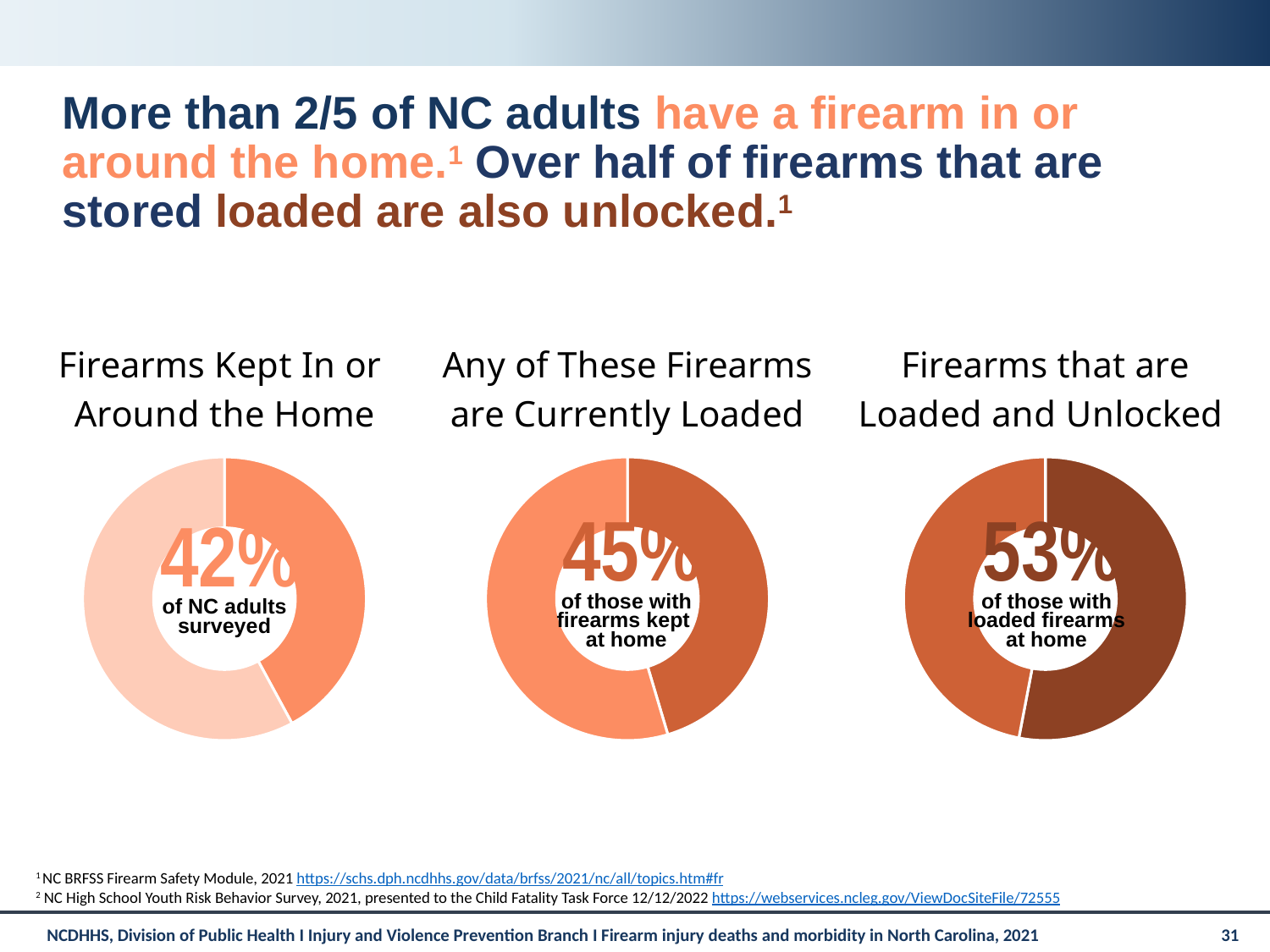
How many donut charts are shown on the slide? 3 In the 'Any of These Firearms are Currently Loaded' chart, what percentage is shown? 45% What kind of chart is used to show the three percentages on the slide? Donut chart In the 'Firearms Kept In or Around the Home' chart, what share of the donut is not covered by the 42% slice? 58% What is the difference between the percentage in the 'Firearms that are Loaded and Unlocked' chart and the percentage in the 'Firearms Kept In or Around the Home' chart? 11 percentage points In the 'Any of These Firearms are Currently Loaded' chart, what group does the 45% refer to, according to the text in the centre of the donut? Those with firearms kept at home In the 'Firearms that are Loaded and Unlocked' chart, what percentage is shown? 53% Which of the three donut charts shows the lowest percentage? Firearms Kept In or Around the Home What is the difference between the percentage in the 'Any of These Firearms are Currently Loaded' chart and the percentage in the 'Firearms Kept In or Around the Home' chart? 3 percentage points Which of the three donut charts shows the highest percentage? Firearms that are Loaded and Unlocked Which is larger: the percentage in the 'Any of These Firearms are Currently Loaded' chart or the percentage in the 'Firearms that are Loaded and Unlocked' chart? Firearms that are Loaded and Unlocked In the 'Firearms Kept In or Around the Home' chart, what percentage is shown in the centre of the donut? 42%